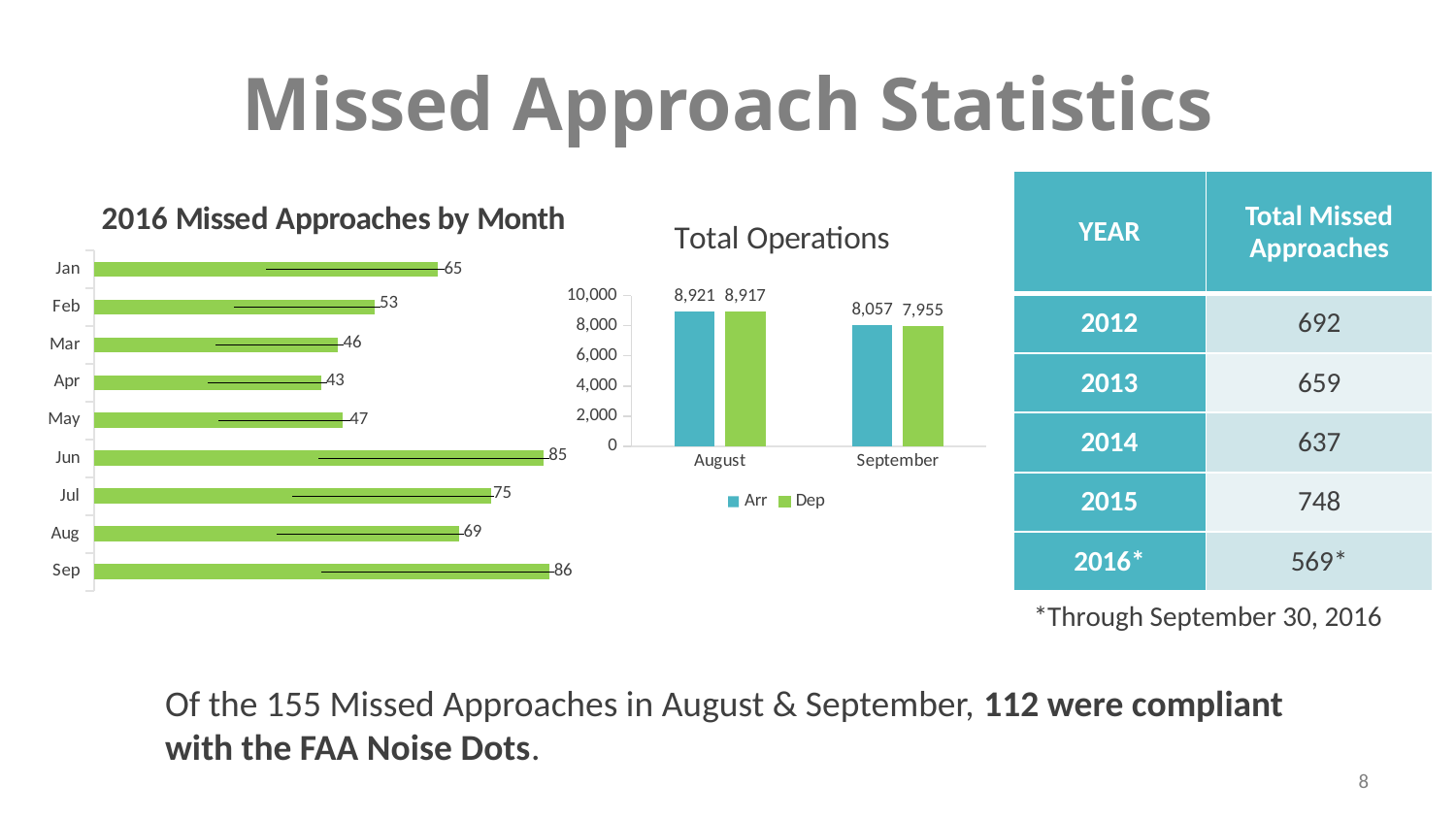
How many series does the legend of the 'Total Operations' chart list? 2 How many months are shown in the '2016 Missed Approaches by Month' chart? 9 In the 'Total Operations' chart, is the Dep value for September greater or less than 8,000? less In the '2016 Missed Approaches by Month' chart, which month has the highest value? Sep In the '2016 Missed Approaches by Month' chart, what is the value for Jan? 65 What kind of chart is the '2016 Missed Approaches by Month' chart? Bar chart In the '2016 Missed Approaches by Month' chart, what is the difference between the values for Jun and May? 38 In the 'Total Operations' chart, what is the Arr value for August? 8,921 In the '2016 Missed Approaches by Month' chart, which is larger, the value for Jul or the value for Aug? Jul In the '2016 Missed Approaches by Month' chart, which month has the lowest value? Apr In the 'Total Operations' chart, what is the Dep value for September? 7,955 In the 'Total Operations' chart, what is the difference between the Arr values for August and September? 864